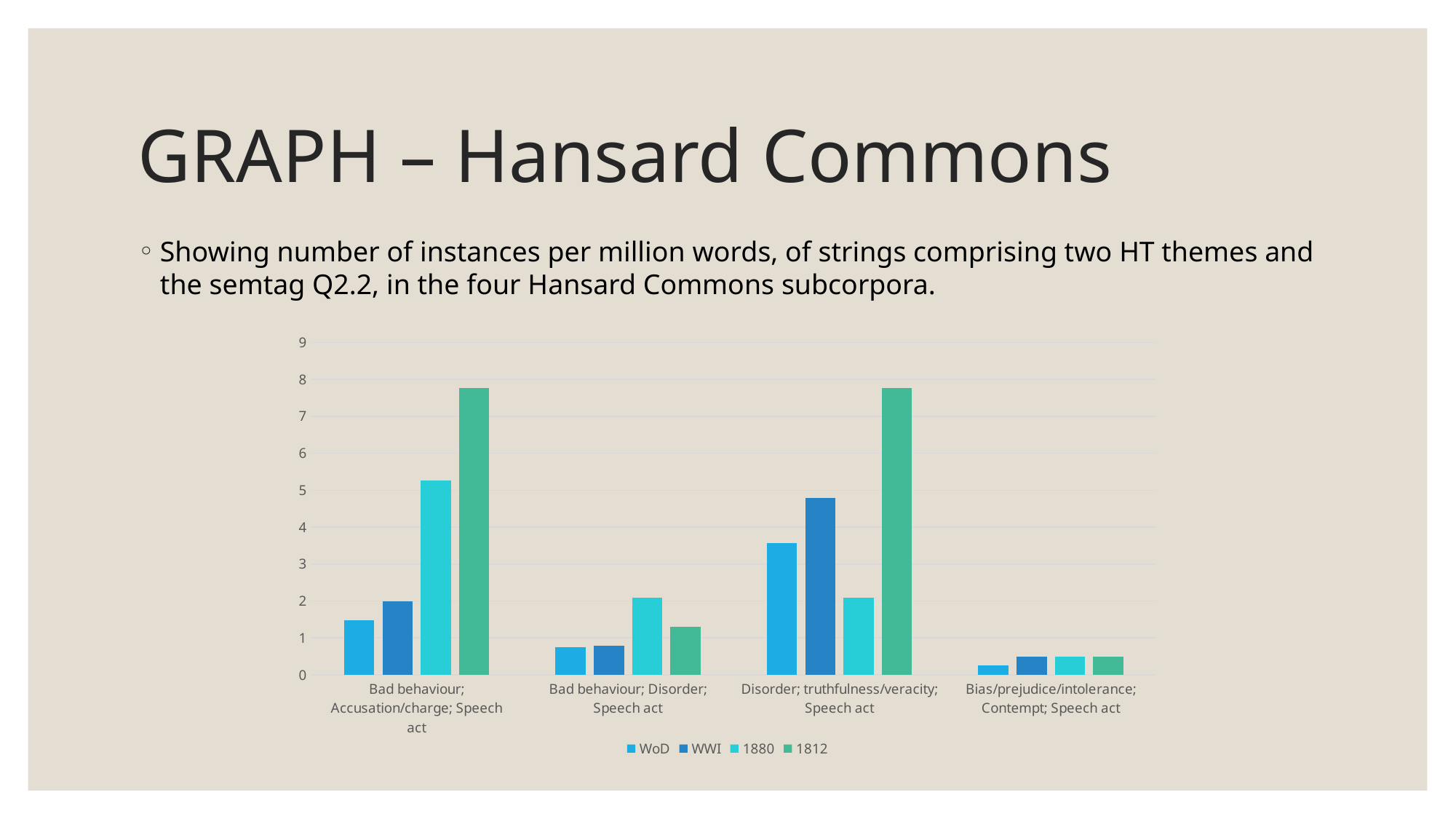
Which series has the highest value in the 'Bad behaviour; Accusation/charge; Speech act' category? 1812 Which series is shown in the legend immediately after WoD? WWI How many categories are shown on the x axis of the chart? 4 Is the value for 1812 in the 'Bad behaviour; Disorder; Speech act' category greater or less than 2? less Which series has the highest value in the 'Bad behaviour; Disorder; Speech act' category? 1880 How many series does the chart legend list? 4 In the 'Disorder; truthfulness/veracity; Speech act' category, which is larger, the WoD value or the WWI value? WWI Which series has the lowest value in the 'Bad behaviour; Accusation/charge; Speech act' category? WoD What kind of chart is shown on the slide? bar chart Is the value for 1812 in the 'Bad behaviour; Accusation/charge; Speech act' category greater or less than 7? greater Is the value for WWI in the 'Disorder; truthfulness/veracity; Speech act' category greater or less than 4? greater In which category does the WWI series reach its highest value? Disorder; truthfulness/veracity; Speech act